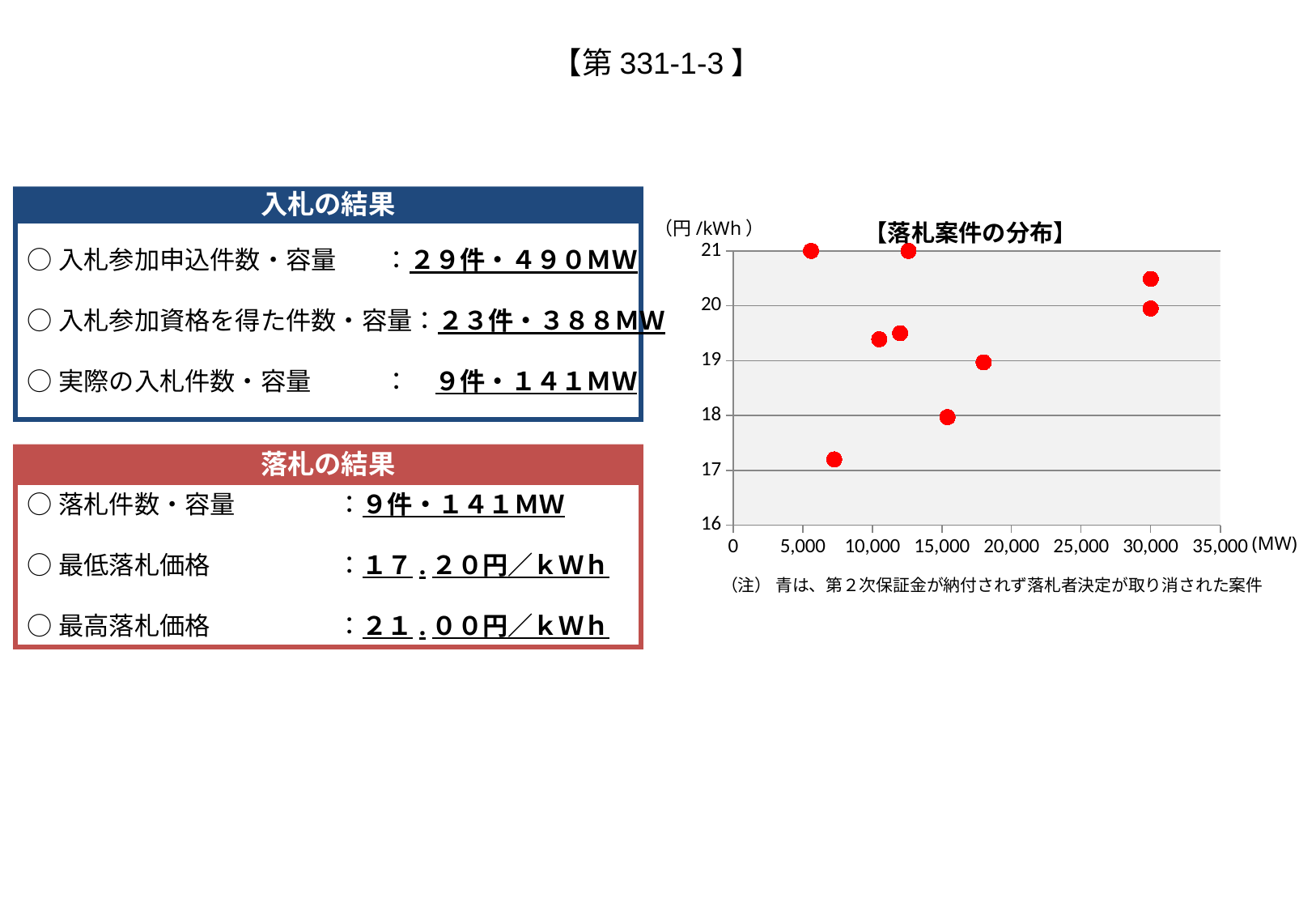
What kind of chart is 【落札案件の分布】? scatter chart How many data points are plotted in the 【落札案件の分布】 chart? 9 In the 【落札案件の分布】 chart, how many points have a capacity greater than 25,000 MW? 2 In the 【落札案件の分布】 chart, is the price of the point at about 7,000 MW greater or less than 18 円/kWh? less In the 【落札案件の分布】 chart, which has the higher price: the point at about 7,000 MW or the point at about 18,000 MW? the point at about 18,000 MW In the 【落札案件の分布】 chart, is the price of the point at about 5,000 MW greater or less than 20 円/kWh? greater What is the title of the chart on the right side of the slide? 【落札案件の分布】 What unit is shown on the vertical axis of the 【落札案件の分布】 chart? 円/kWh What is the maximum value shown on the horizontal axis of the 【落札案件の分布】 chart? 35,000 In the 【落札案件の分布】 chart, is the price of the higher point at about 30,000 MW greater or less than 20 円/kWh? greater In the 【落札案件の分布】 chart, how many points have a capacity less than 10,000 MW? 2